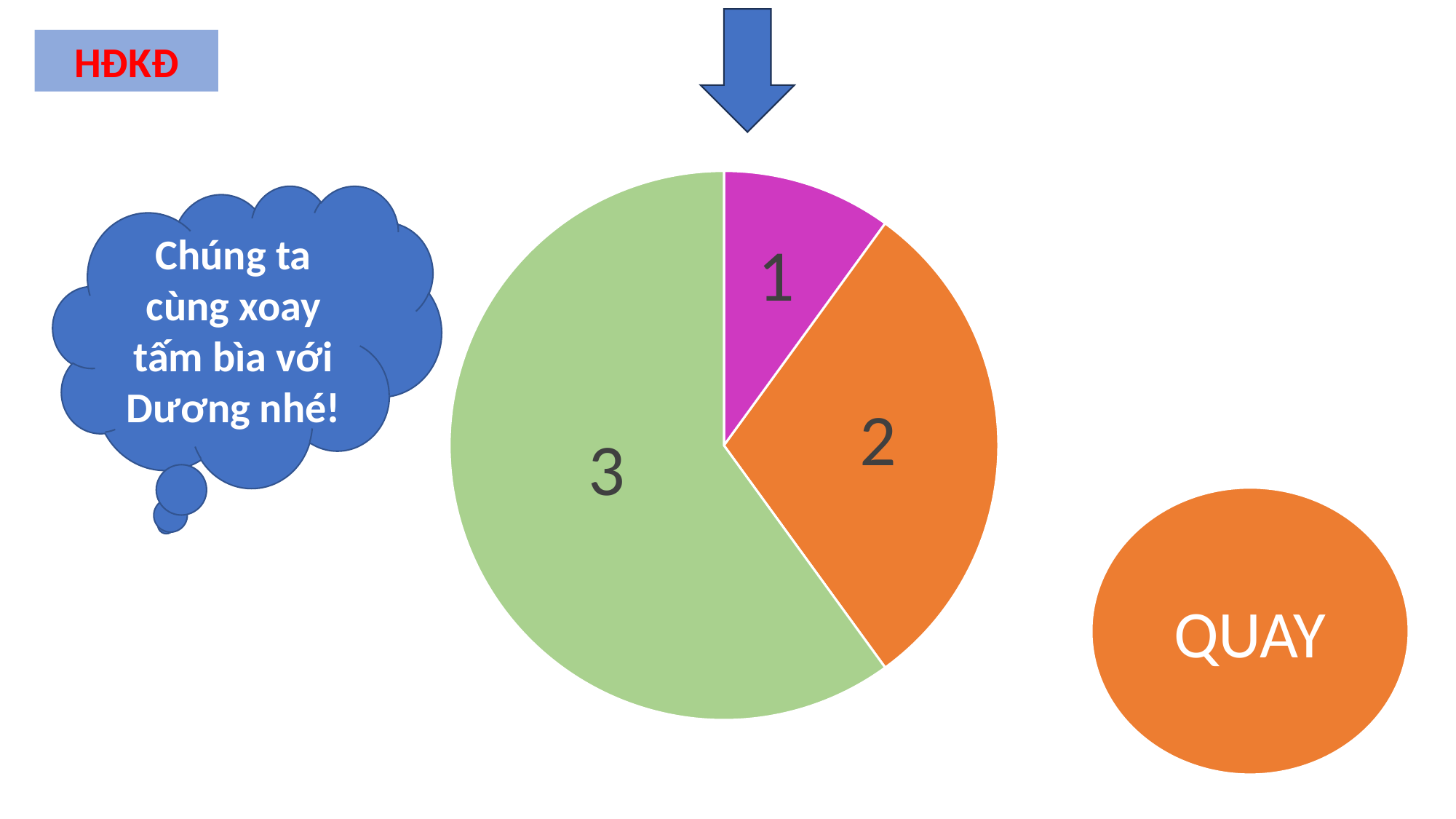
How many slices does the pie chart have? 3 Which slice of the pie chart is the smallest? 1 What kind of chart is shown on the slide? pie chart What colour is slice 3 in the pie chart? green What colour is slice 1 in the pie chart? magenta Which slice of the pie chart is the largest? 3 Which slice is larger in the pie chart, slice 2 or slice 3? 3 Which slice is larger in the pie chart, slice 1 or slice 2? 2